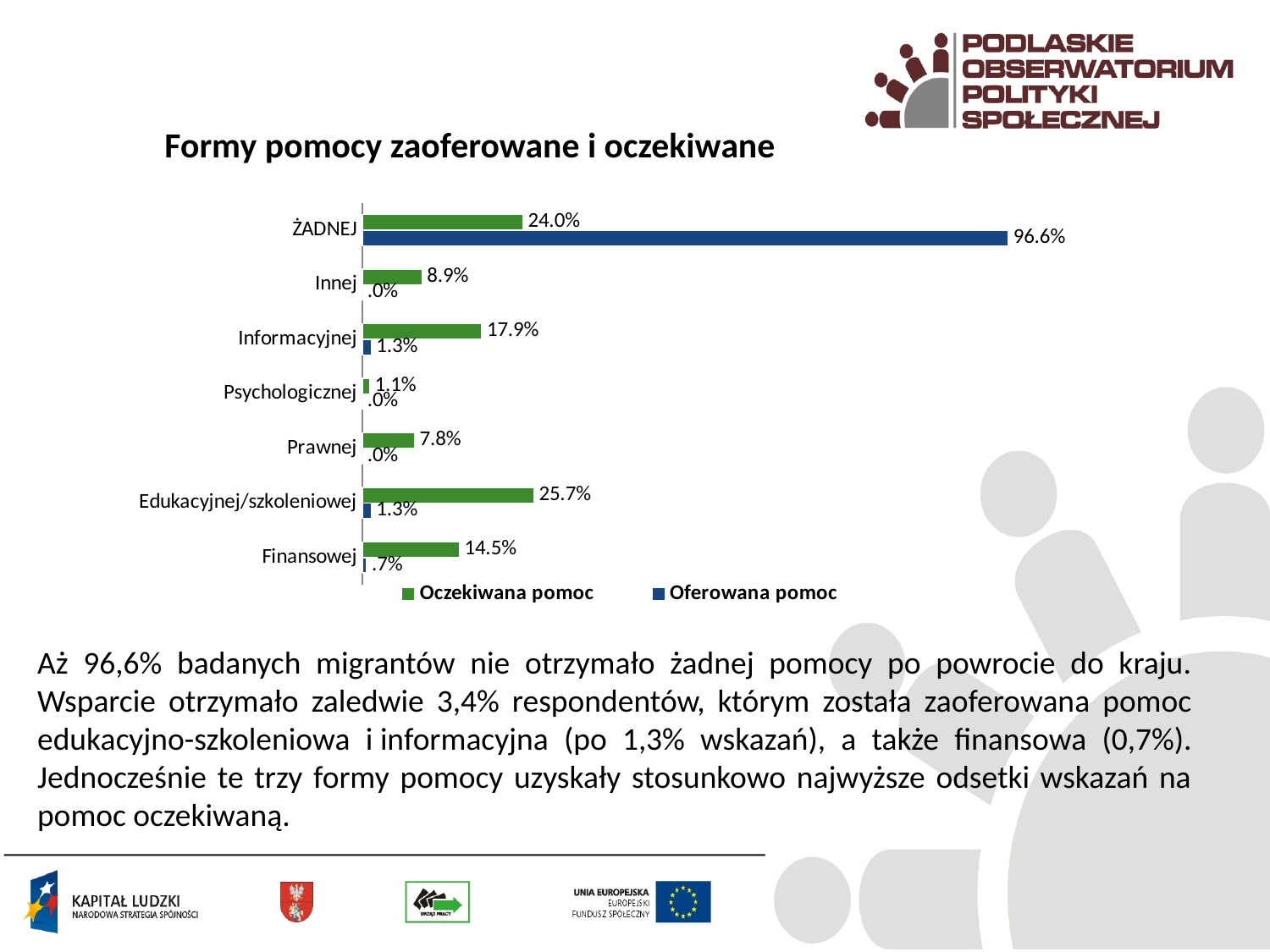
What is the difference between Oczekiwana pomoc and Oferowana pomoc for ŻADNEJ? 72.6% What is the value of Oczekiwana pomoc for Edukacyjnej/szkoleniowej? 25.7% Which category has the highest value for Oczekiwana pomoc? Edukacyjnej/szkoleniowej What is the value of Oferowana pomoc for ŻADNEJ? 96.6% What is the title of the chart? Formy pomocy zaoferowane i oczekiwane How many categories are shown on the chart? 7 How many series does the legend list? 2 What type of chart is shown on the slide? bar chart Which category has the lowest value for Oczekiwana pomoc? Psychologicznej What is the value of Oferowana pomoc for Finansowej? .7% Which is larger for Finansowej: Oczekiwana pomoc or Oferowana pomoc? Oczekiwana pomoc What is the value of Oczekiwana pomoc for Informacyjnej? 17.9%